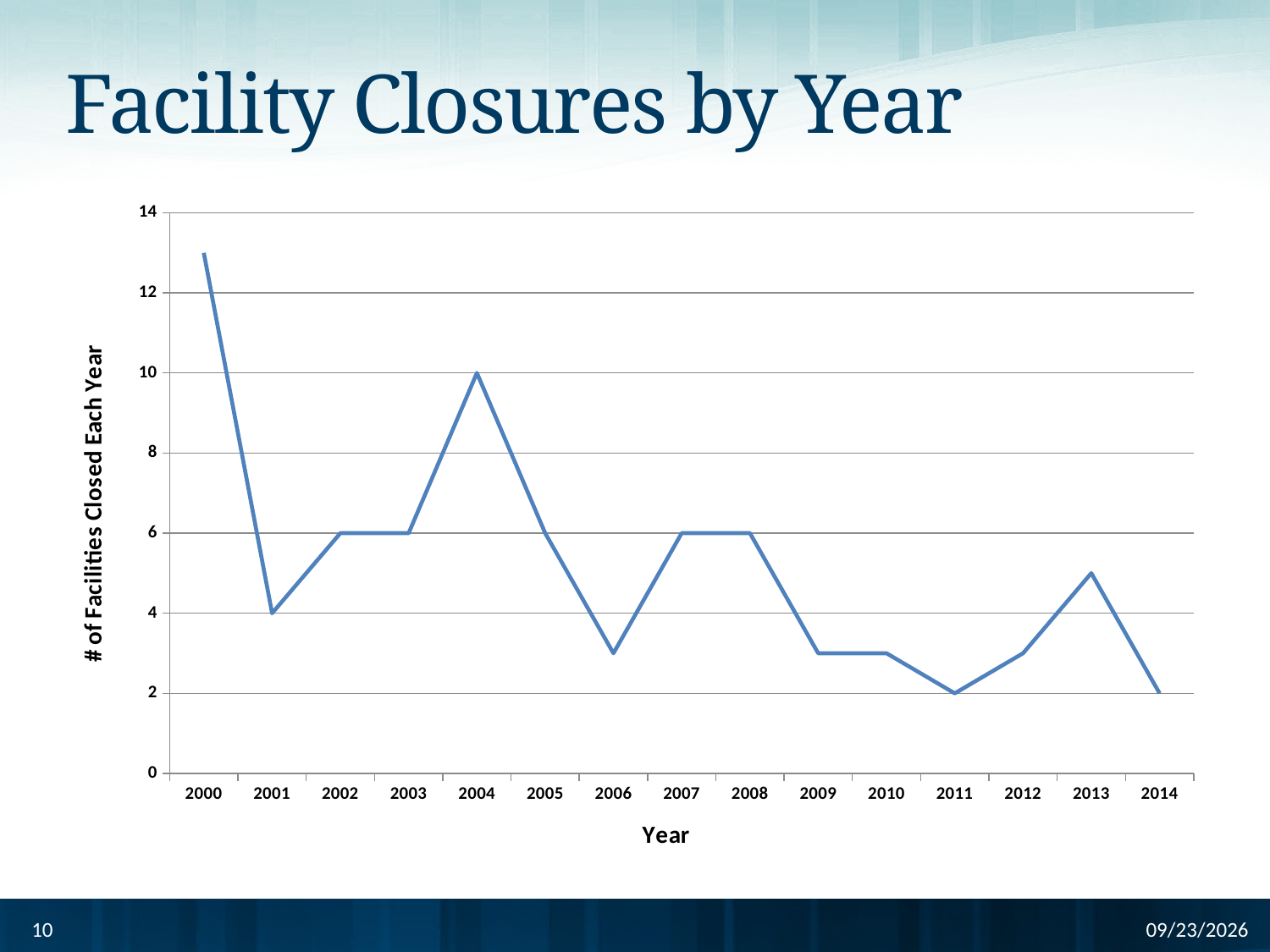
How many years are plotted on the x axis? 15 How many facilities were closed in 2011? 2 Is the value for 2006 greater or less than 4? less Is the value for 2000 greater or less than 12? greater What is the title of the chart? Facility Closures by Year What is the difference between the number of facilities closed in 2004 and in 2001? 6 How many facilities were closed in 2014? 2 How many facilities were closed in 2004? 10 What type of chart is shown on the slide? line chart Overall, do facility closures rise or fall from 2000 to 2014? fall How many facilities were closed in 2001? 4 Which year has the highest number of facilities closed? 2000